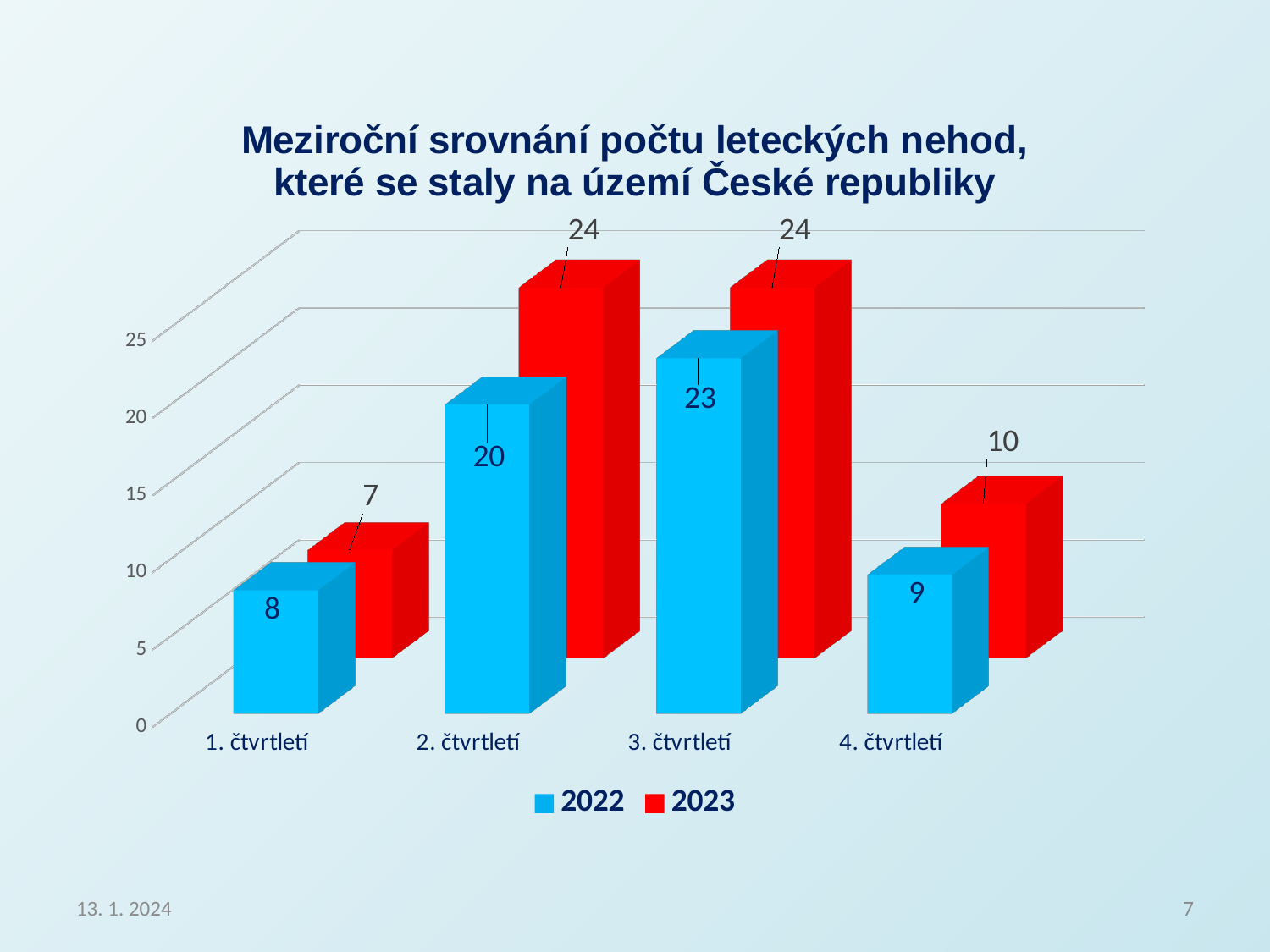
What is the difference between the 2023 and 2022 values in 2. čtvrtletí? 4 Which quarter has the lowest value for 2023? 1. čtvrtletí What is the value for 2023 in 2. čtvrtletí? 24 Which is larger in 1. čtvrtletí, the value for 2022 or for 2023? 2022 Which quarter has the highest value for 2022? 3. čtvrtletí How many quarters are shown on the x axis? 4 What is the value for 2023 in 4. čtvrtletí? 10 What is the value for 2022 in 3. čtvrtletí? 23 Which colour represents the 2023 series in the legend? red How many series does the legend list? 2 What kind of chart is shown on the slide? bar chart What is the value for 2022 in 1. čtvrtletí? 8